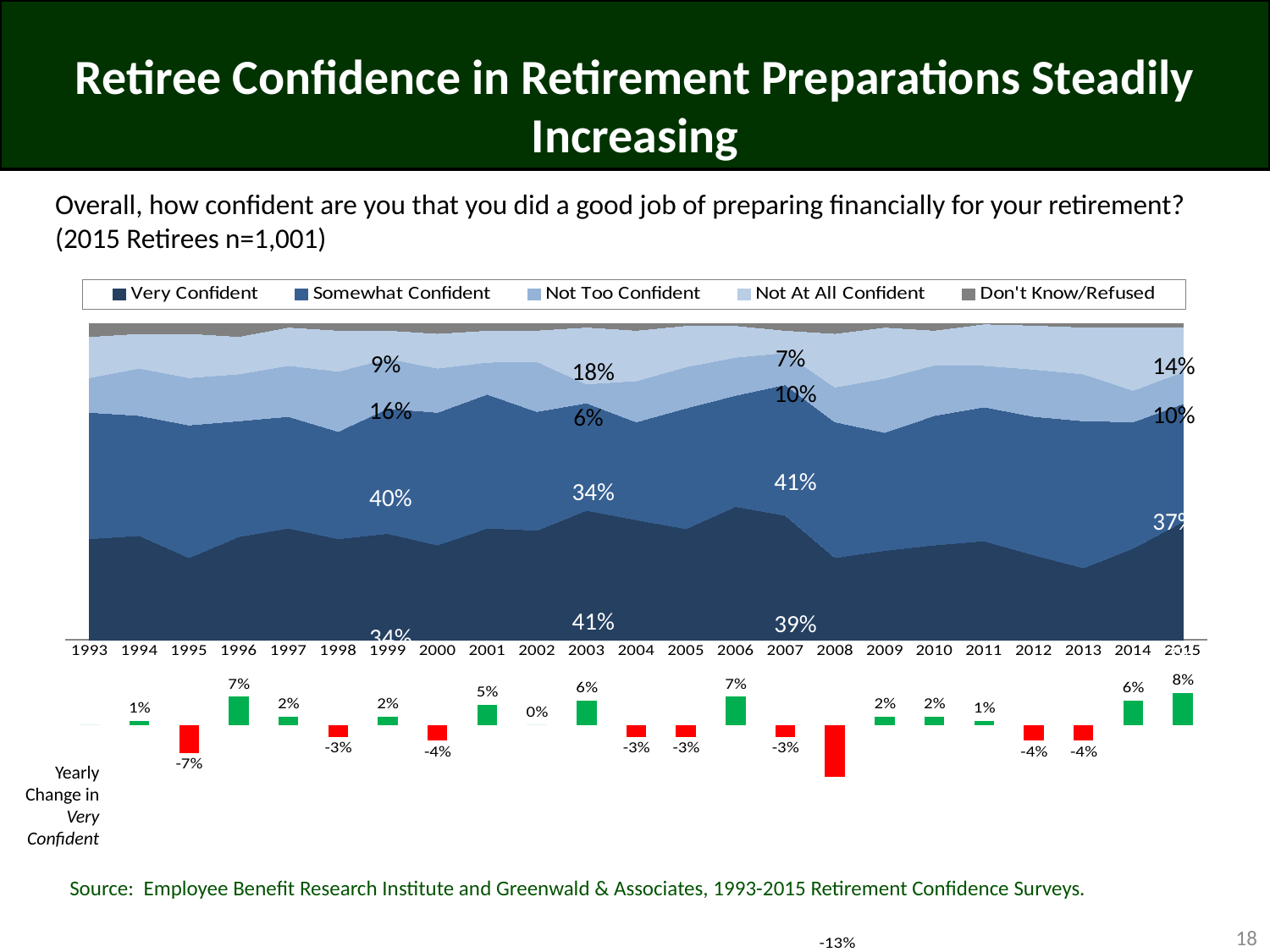
In the top chart, what is the value for Somewhat Confident in 1999? 40% How many series does the legend of the top chart list? 5 What kind of chart is the top chart showing confidence levels from 1993 to 2015? Stacked area chart What kind of chart is the bottom chart showing yearly change in Very Confident? Bar chart In the top chart, what is the value for Somewhat Confident in 2007? 41% In the bottom chart of yearly change in Very Confident, which year has the highest value? 2015 In the bottom chart of yearly change in Very Confident, which year has the lowest value? 2008 In the top chart, what is the value for Not At All Confident in 2015? 14% In the top chart, which is larger in 2003: Very Confident or Somewhat Confident? Very Confident In the top chart, what is the difference between Somewhat Confident and Very Confident in 2007? 2 percentage points In the top chart, what is the value for Not Too Confident in 2003? 6% In the bottom chart of yearly change in Very Confident, what is the value for 2015? 8%